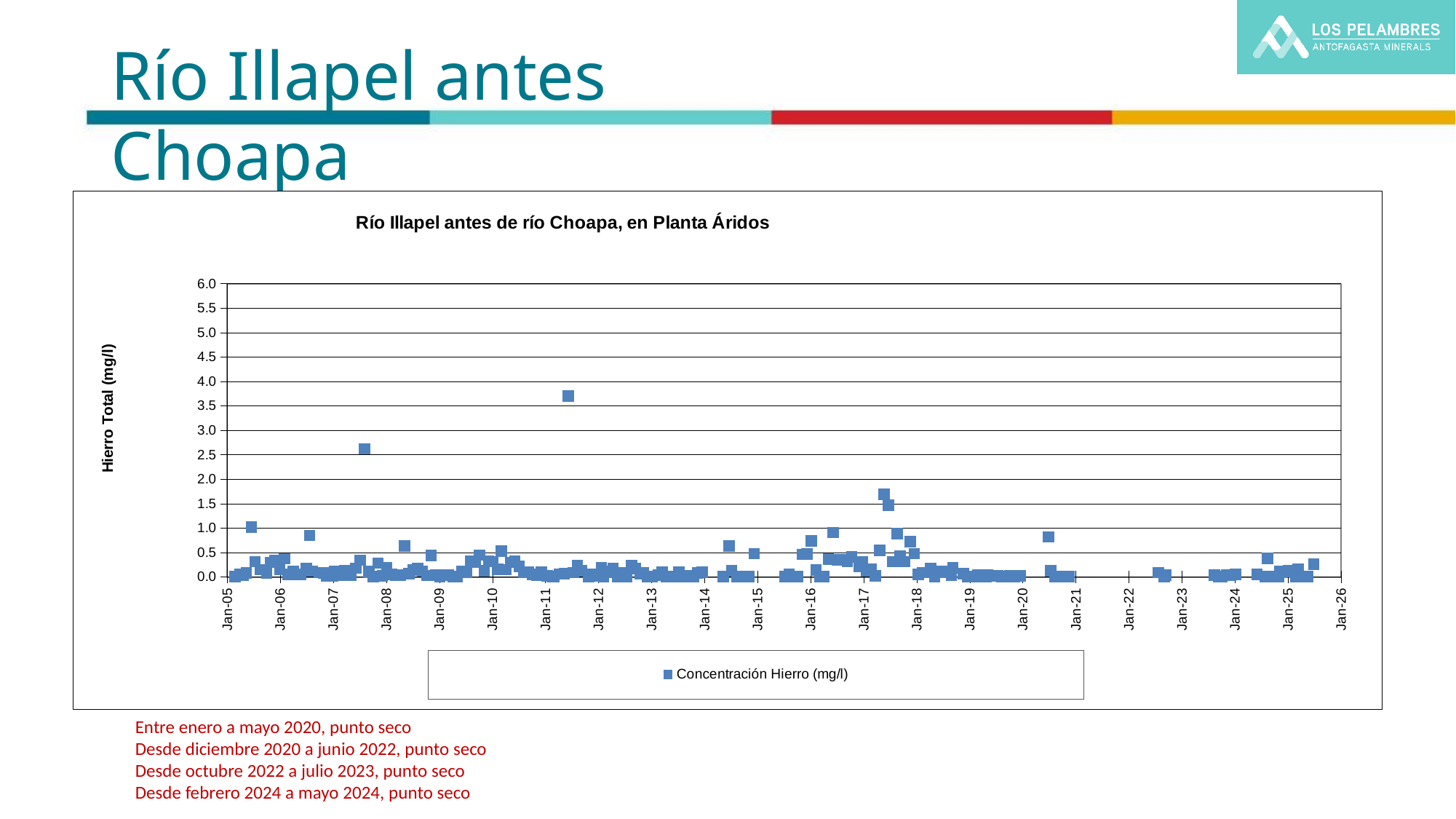
How many series does the legend list? 1 Which is larger: the highest point between Jan-11 and Jan-12, or the highest point between Jan-07 and Jan-08? The highest point between Jan-11 and Jan-12 What kind of chart is shown on the slide? Scatter chart Between which two x-axis labels does the highest plotted point fall? Jan-11 and Jan-12 What is the maximum value shown on the y axis? 6.0 Is the highest point between Jan-07 and Jan-08 greater or less than 2.0? greater Is the highest plotted value greater or less than 4.0? less Is the highest point between Jan-20 and Jan-21 greater or less than 0.5? greater What is the name of the series shown in the legend? Concentración Hierro (mg/l) What is the title of the chart? Río Illapel antes de río Choapa, en Planta Áridos